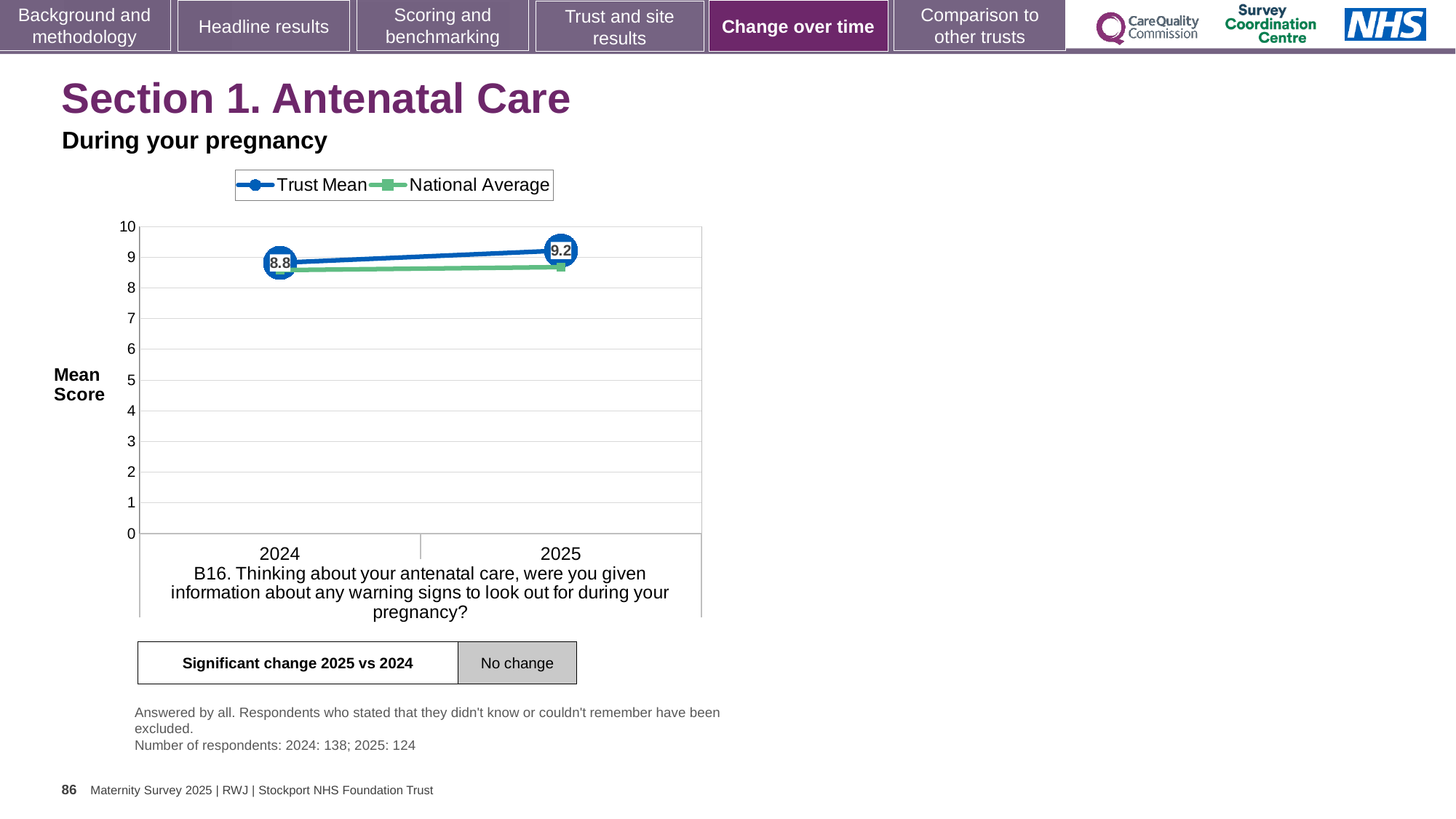
What is the Trust Mean score for 2025? 9.2 Does the Trust Mean rise or fall from 2024 to 2025? rise How many series does the legend list? 2 By how much did the Trust Mean change from 2024 to 2025? 0.4 How many years are plotted on the x axis? 2 Is the National Average value for 2025 greater or less than 8? greater In 2025, which is higher, the Trust Mean or the National Average? Trust Mean What is the Trust Mean score for 2024? 8.8 What is the label on the y axis of the chart? Mean Score What kind of chart is shown on the slide? line chart In which year is the Trust Mean higher, 2024 or 2025? 2025 Is the National Average value for 2024 greater or less than 9? less